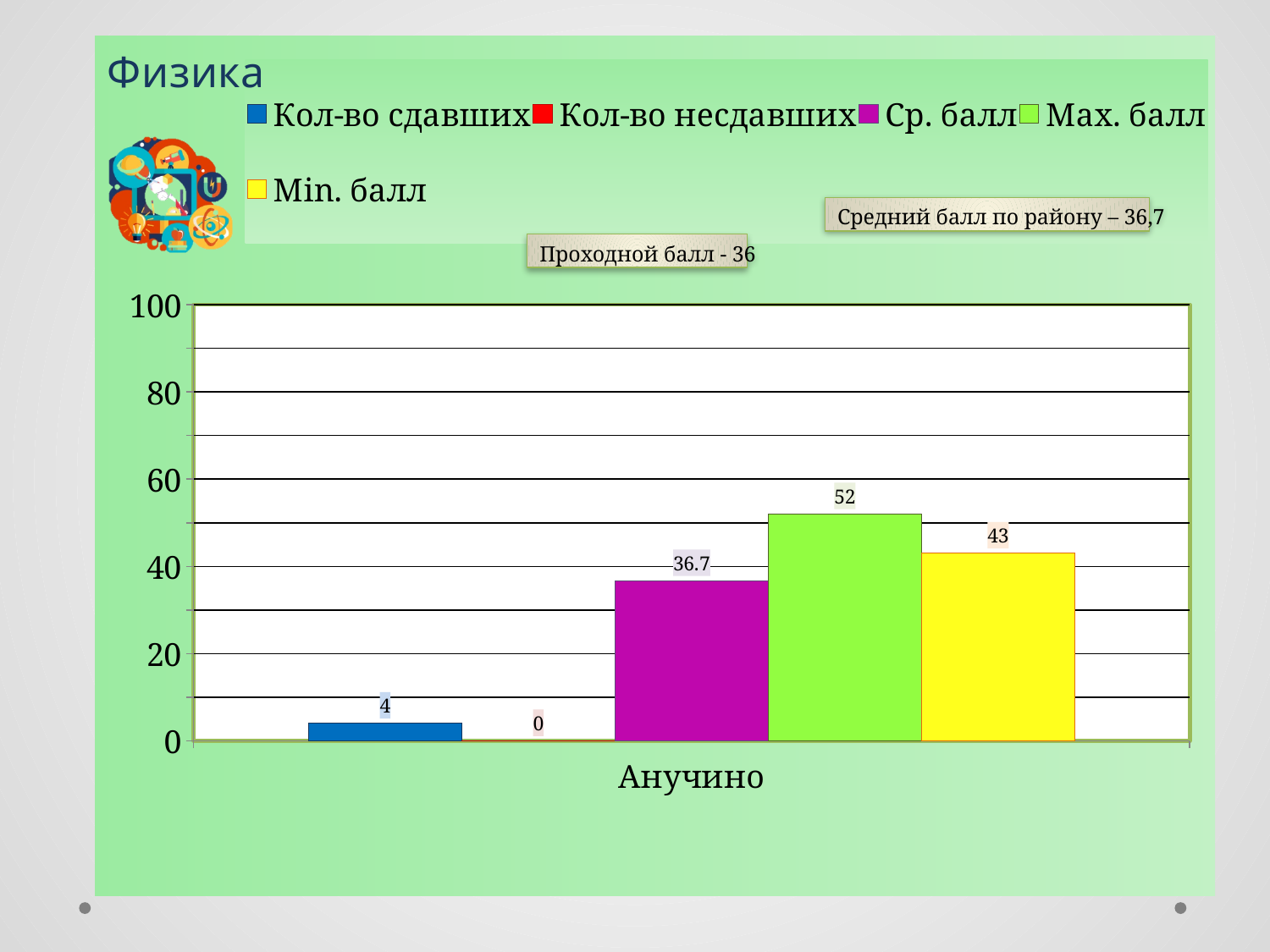
Which is larger, Ср. балл or Min. балл? Min. балл What kind of chart is shown on the slide? Bar chart What is the value for Min. балл in Анучино? 43 What is the value for Кол-во сдавших in Анучино? 4 Which series has the lowest value in the chart? Кол-во несдавших How many series does the legend list? 5 What is the difference between Max. балл and Min. балл? 9 What is the value for Ср. балл in Анучино? 36.7 What is the value for Max. балл in Анучино? 52 Which series has the highest value in the chart? Max. балл How many categories are shown on the x axis? 1 What is the value for Кол-во несдавших in Анучино? 0